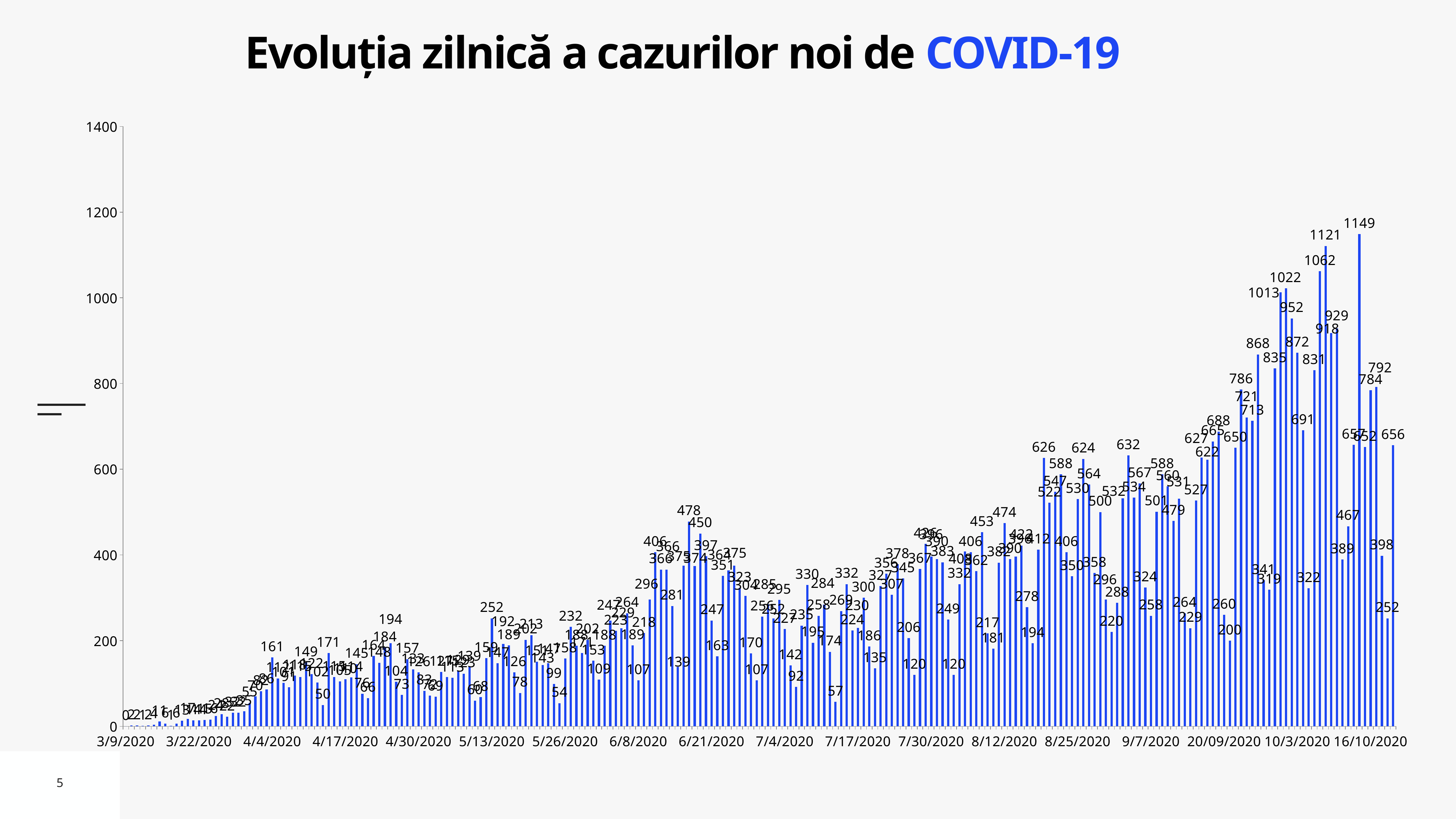
What is the second highest daily value labelled in the chart? 1121 What is the title of the chart? Evoluția zilnică a cazurilor noi de COVID-19 What is the highest daily value shown in the chart? 1149 What is the maximum value shown on the vertical axis? 1400 What is the difference between the two highest labelled values, 1149 and 1121? 28 What is the value of the last (rightmost) bar in the chart? 656 What is the lowest value labelled in the chart? 0 What kind of chart is shown on the slide? bar chart Which is larger, the bar labelled 1062 or the bar labelled 1121? 1121 Is the highest bar in the chart greater or less than 1000? greater Overall, do the daily values rise or fall from left to right along the x axis? rise Is the value of the rightmost bar greater or less than 600? greater